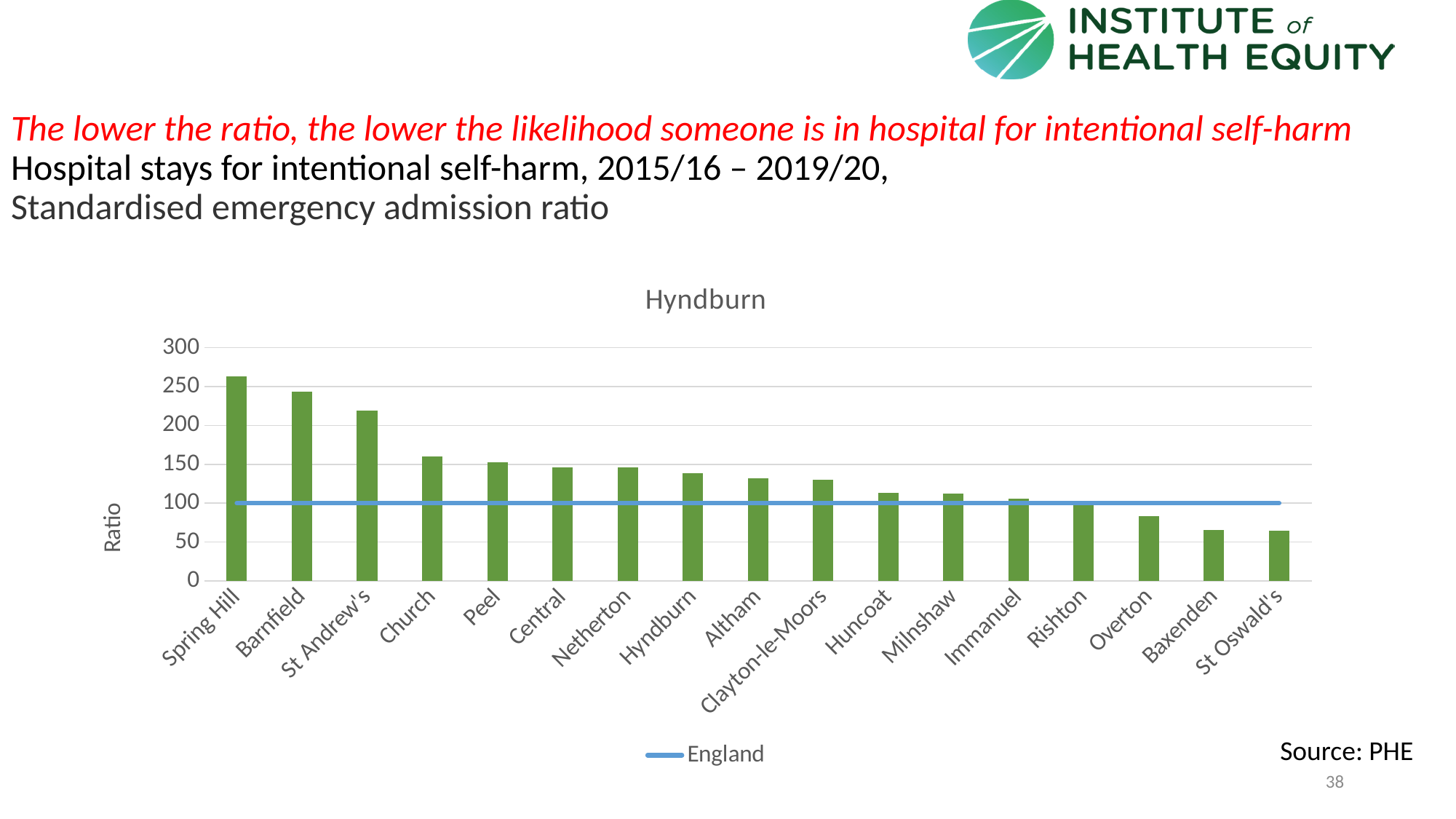
What kind of chart is shown on the slide? bar chart What is the title of the chart? Hyndburn Which has the larger ratio, Spring Hill or Barnfield? Spring Hill Is the value for Spring Hill greater or less than 250? greater Is the value for Baxenden greater or less than 100? less Is the value for Overton greater or less than 100? less How many series does the legend list? 1 Do the bar values rise or fall from left to right along the x axis? fall How many areas (bars) are plotted in the Hyndburn chart? 17 Which area has the highest ratio? Spring Hill